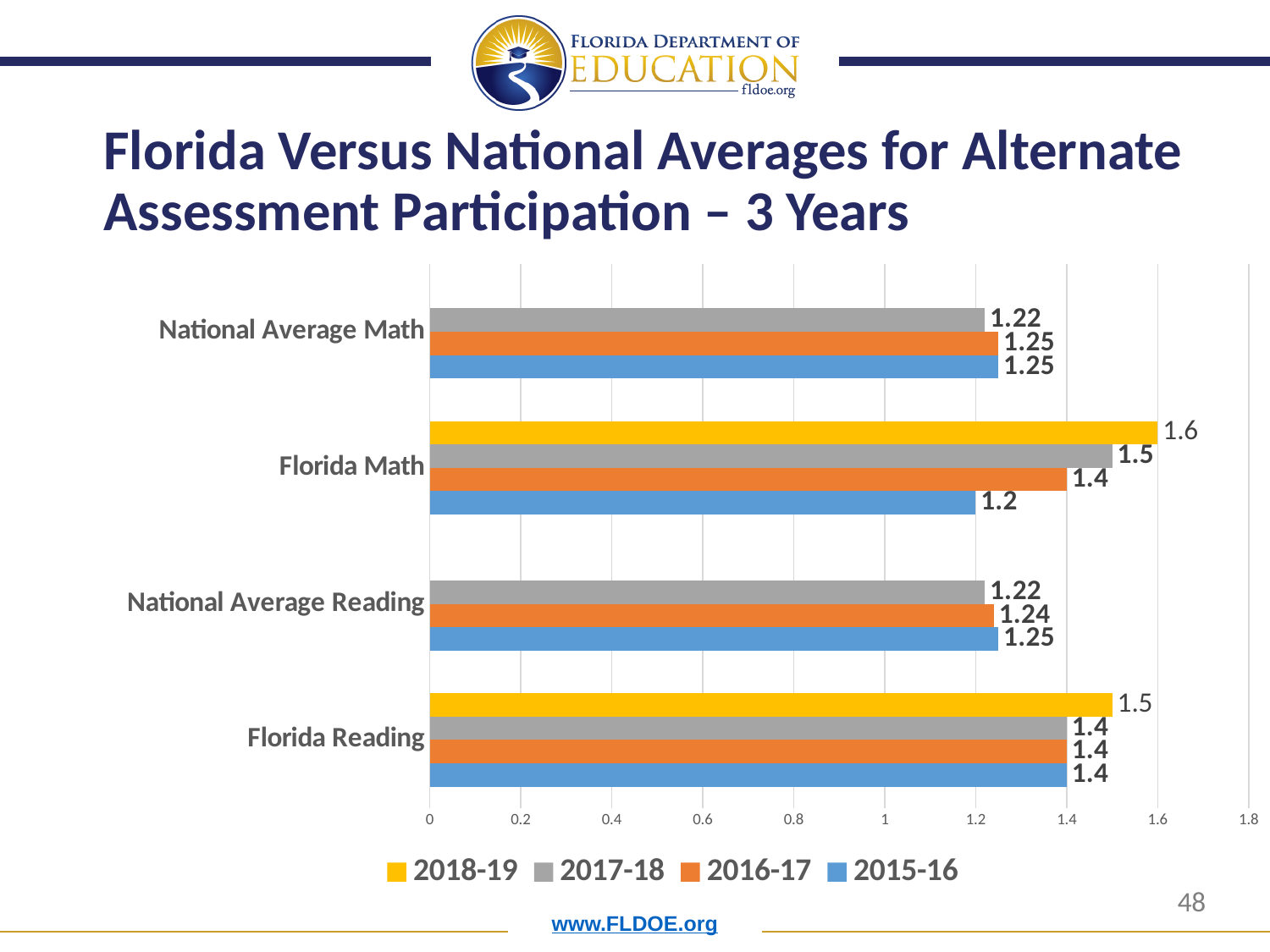
What is the value for National Average Math in 2017-18? 1.22 What is the difference between the Florida Math values for 2018-19 and 2015-16? 0.4 What is the value for Florida Math in 2018-19? 1.6 Which is larger: Florida Math in 2017-18 or National Average Math in 2017-18? Florida Math in 2017-18 Which category has the lowest value in the 2015-16 series? Florida Math What is the value for National Average Reading in 2016-17? 1.24 How many categories are shown on the chart? 4 Which category has the highest value in the 2018-19 series? Florida Math Which series is shown in yellow in the legend? 2018-19 What kind of chart is shown on the slide? Bar chart How many series does the legend list? 4 What is the value for Florida Reading in 2015-16? 1.4